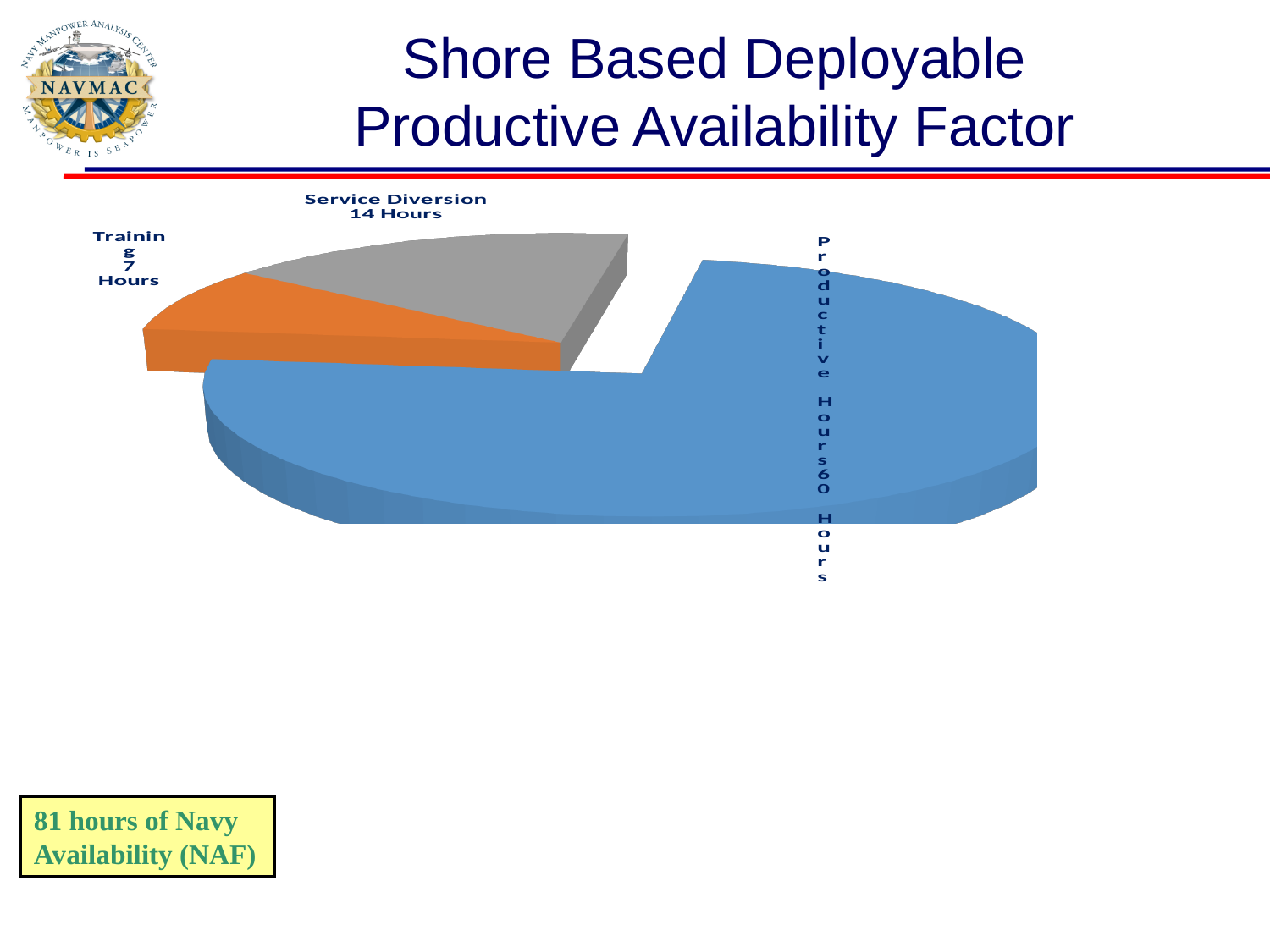
What is the difference in hours between Service Diversion and Training? 7 Hours How many slices does the pie chart have? 3 How many hours are shown for Training? 7 Hours How many hours are shown for Service Diversion? 14 Hours How many hours are shown for Productive Hours? 60 Hours What is the total number of hours across all three slices of the pie chart? 81 hours What is the difference in hours between Productive Hours and Service Diversion? 46 Hours Which slice of the pie chart is the smallest? Training Which is larger, Service Diversion or Training? Service Diversion What kind of chart is shown on the slide? pie chart Which slice of the pie chart is the largest? Productive Hours What colour is the Productive Hours slice? blue